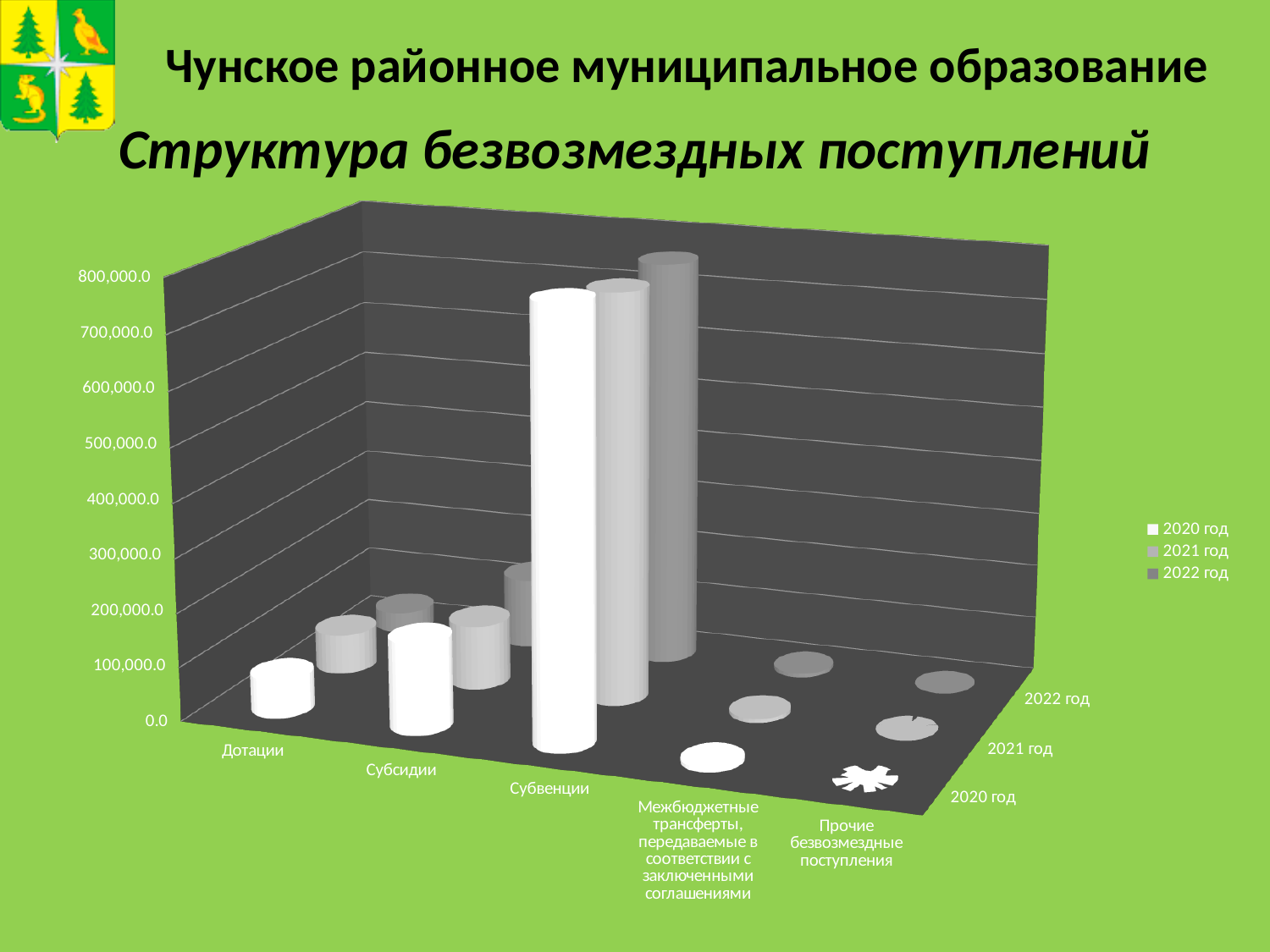
Which category has the highest value for 2022 год? Субвенции Is the value for Прочие безвозмездные поступления in 2020 год greater or less than 100,000.0? less Is the value for Дотации in 2020 год greater or less than 300,000.0? less How many series does the legend list? 3 Which category has the highest value for 2020 год? Субвенции What kind of chart is shown on the slide? bar chart How many categories are shown along the x axis? 5 What are the three entries listed in the legend? 2020 год, 2021 год, 2022 год Which is larger for 2020 год: Субвенции or Дотации? Субвенции Is the value for Субвенции in 2020 год greater or less than 400,000.0? greater Which is larger for 2021 год: Субсидии or Прочие безвозмездные поступления? Субсидии Which category has the lowest value for 2020 год? Прочие безвозмездные поступления